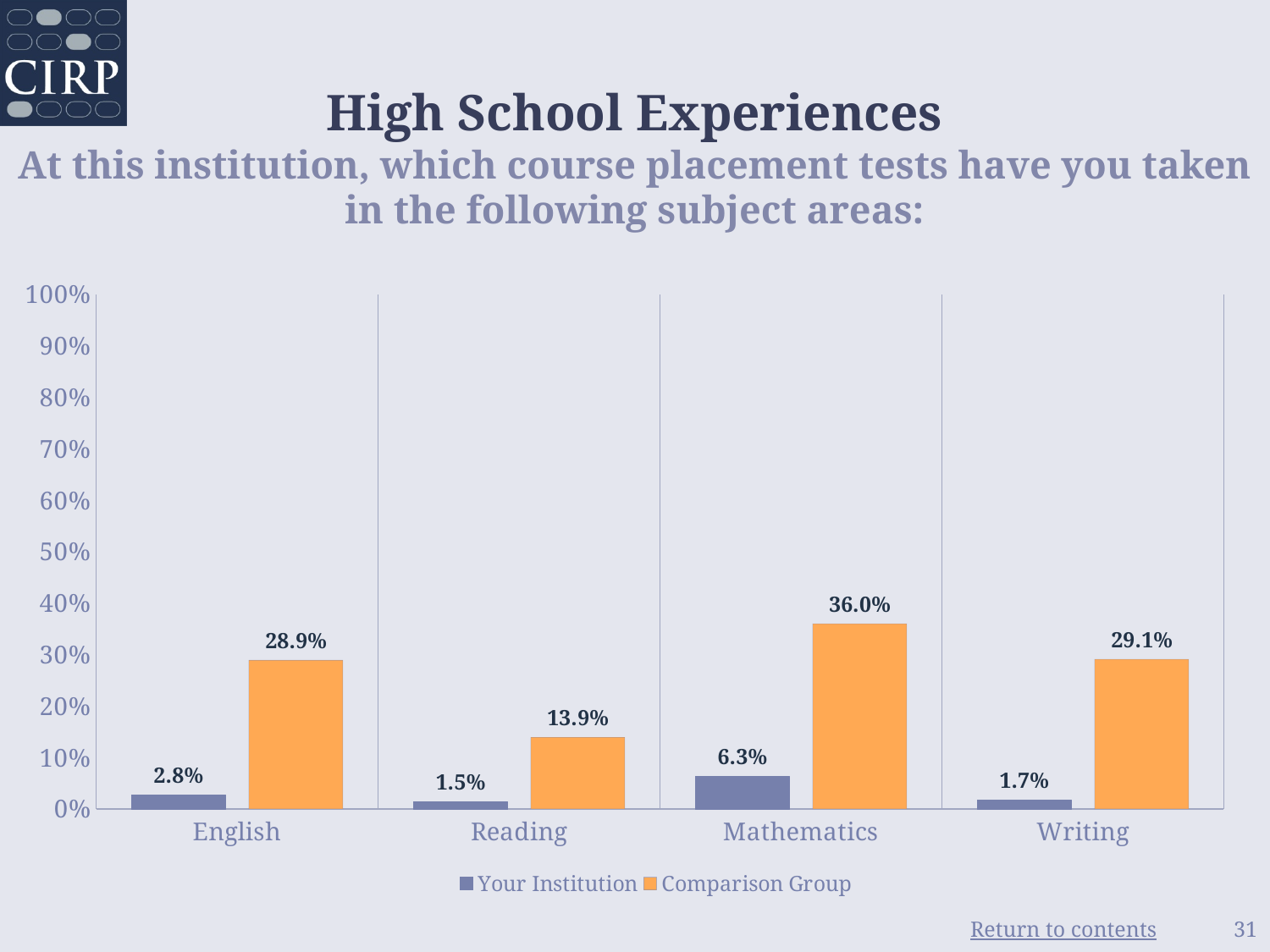
What is the value for Your Institution in Mathematics? 6.3% Is the Comparison Group value for Mathematics greater or less than 30%? greater What kind of chart is shown on the slide? bar chart What is the difference between the Comparison Group and Your Institution values for English? 26.1% Which series is shown in orange? Comparison Group How many subject areas are shown on the x axis? 4 How many series does the legend list? 2 Which is larger: the Comparison Group value for Writing or for English? Writing Which subject area has the lowest Your Institution value? Reading What is the value for the Comparison Group in Reading? 13.9% Which subject area has the highest Comparison Group value? Mathematics What is the value for Your Institution in Writing? 1.7%